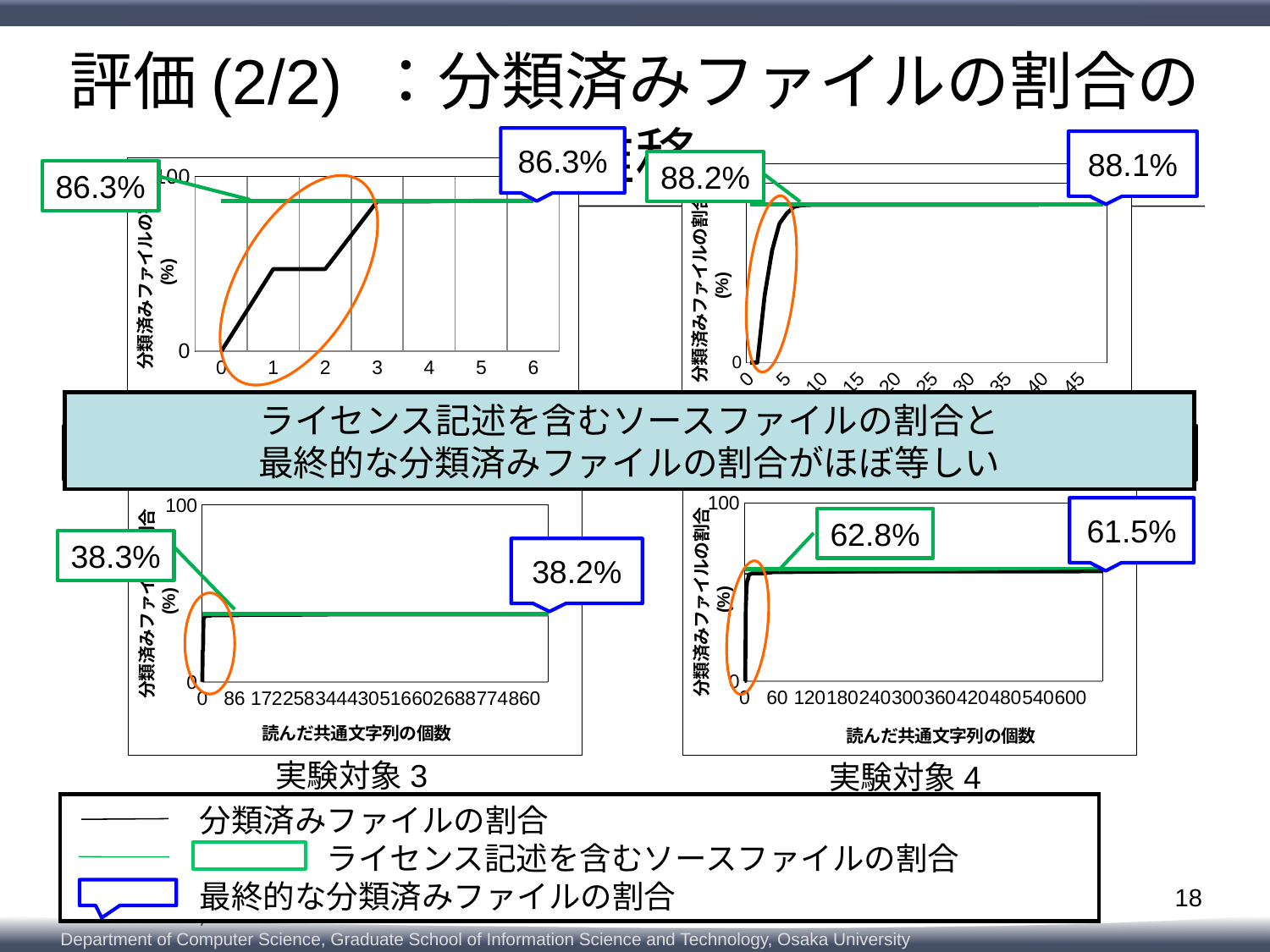
In the top-right chart, what value is shown in the green box for ライセンス記述を含むソースファイルの割合? 88.2% What is the x-axis label of the bottom-left chart (実験対象 3)? 読んだ共通文字列の個数 Among the four charts, which one shows the highest 最終的な分類済みファイルの割合 in its blue callout? The top-right chart (88.1%) In the bottom-right chart (実験対象 4), what is the difference between the green box value (62.8%) and the blue callout value (61.5%)? 1.3 percentage points In the top-right chart, what value is shown in the blue callout for 最終的な分類済みファイルの割合? 88.1% Which has the larger 最終的な分類済みファイルの割合 (blue callout): 実験対象 3 or 実験対象 4? 実験対象 4 In the top-left chart, what value is shown in the green box for ライセンス記述を含むソースファイルの割合? 86.3% In the bottom-right chart (実験対象 4), what is the value shown in the green box for ライセンス記述を含むソースファイルの割合? 62.8% In the bottom-right chart (実験対象 4), what is the value shown in the blue callout for 最終的な分類済みファイルの割合? 61.5% What kind of chart is used in each of the four panels on the slide? Line chart In the bottom-left chart (実験対象 3), what is the value shown in the blue callout for 最終的な分類済みファイルの割合? 38.2% In the bottom-left chart (実験対象 3), what is the value shown in the green box for ライセンス記述を含むソースファイルの割合? 38.3%